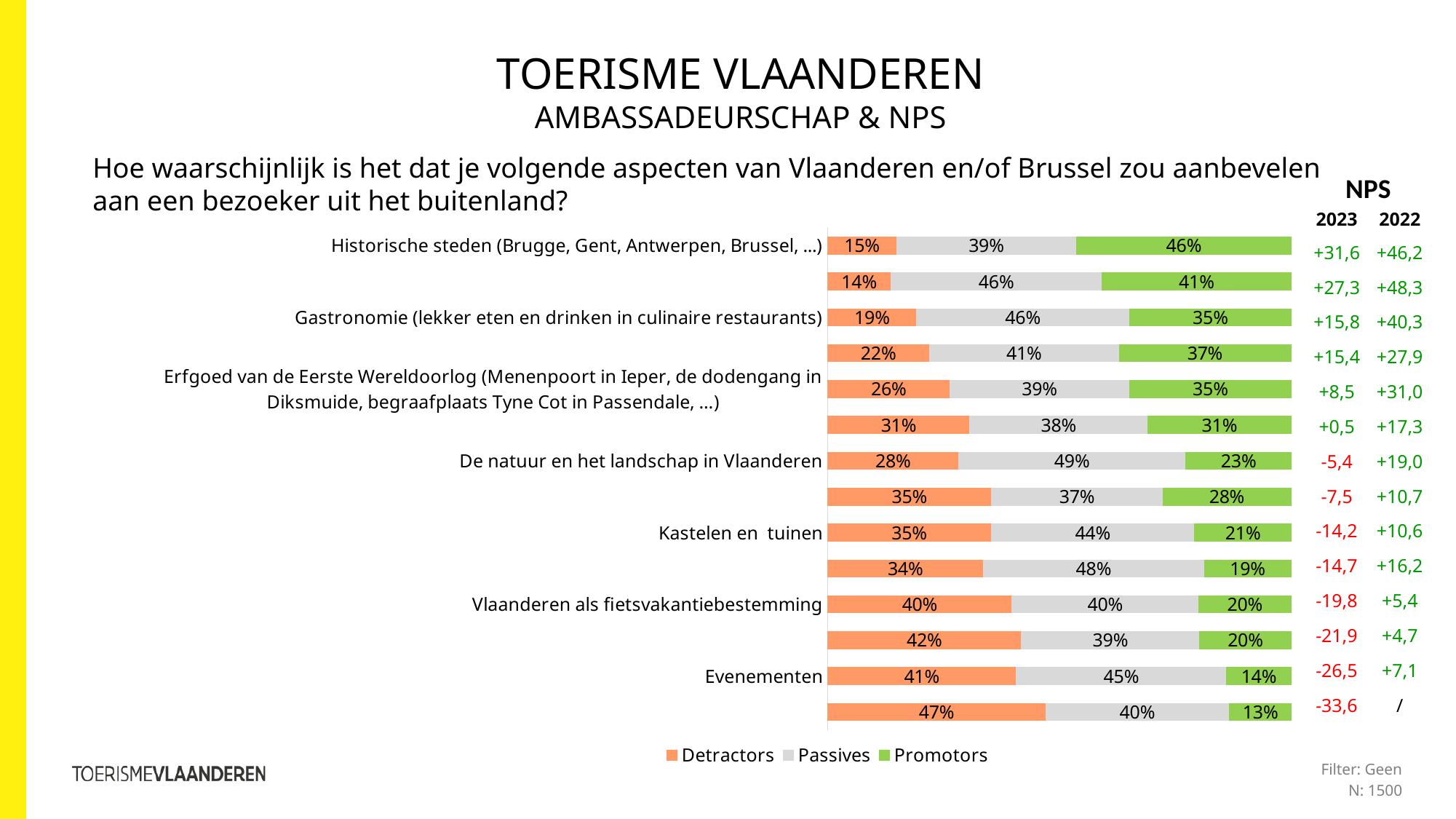
What is the difference between the Promotors percentage for Gastronomie and for Kastelen en tuinen? 14% What is the Detractors percentage for Evenementen? 41% What is the Promotors percentage for Historische steden (Brugge, Gent, Antwerpen, Brussel, ...)? 46% Among the labelled categories, which has the lowest Promotors percentage? Evenementen Among the labelled categories, which has the highest Promotors percentage? Historische steden (Brugge, Gent, Antwerpen, Brussel, ...) What type of chart is shown on the slide? stacked bar chart How many series does the legend list? 3 What is the Detractors percentage for Vlaanderen als fietsvakantiebestemming? 40% What is the Passives percentage for De natuur en het landschap in Vlaanderen? 49% How many bars are plotted in the chart? 14 What are the three series named in the legend? Detractors, Passives, Promotors Which has a larger Detractors percentage: Erfgoed van de Eerste Wereldoorlog or Kastelen en tuinen? Kastelen en tuinen